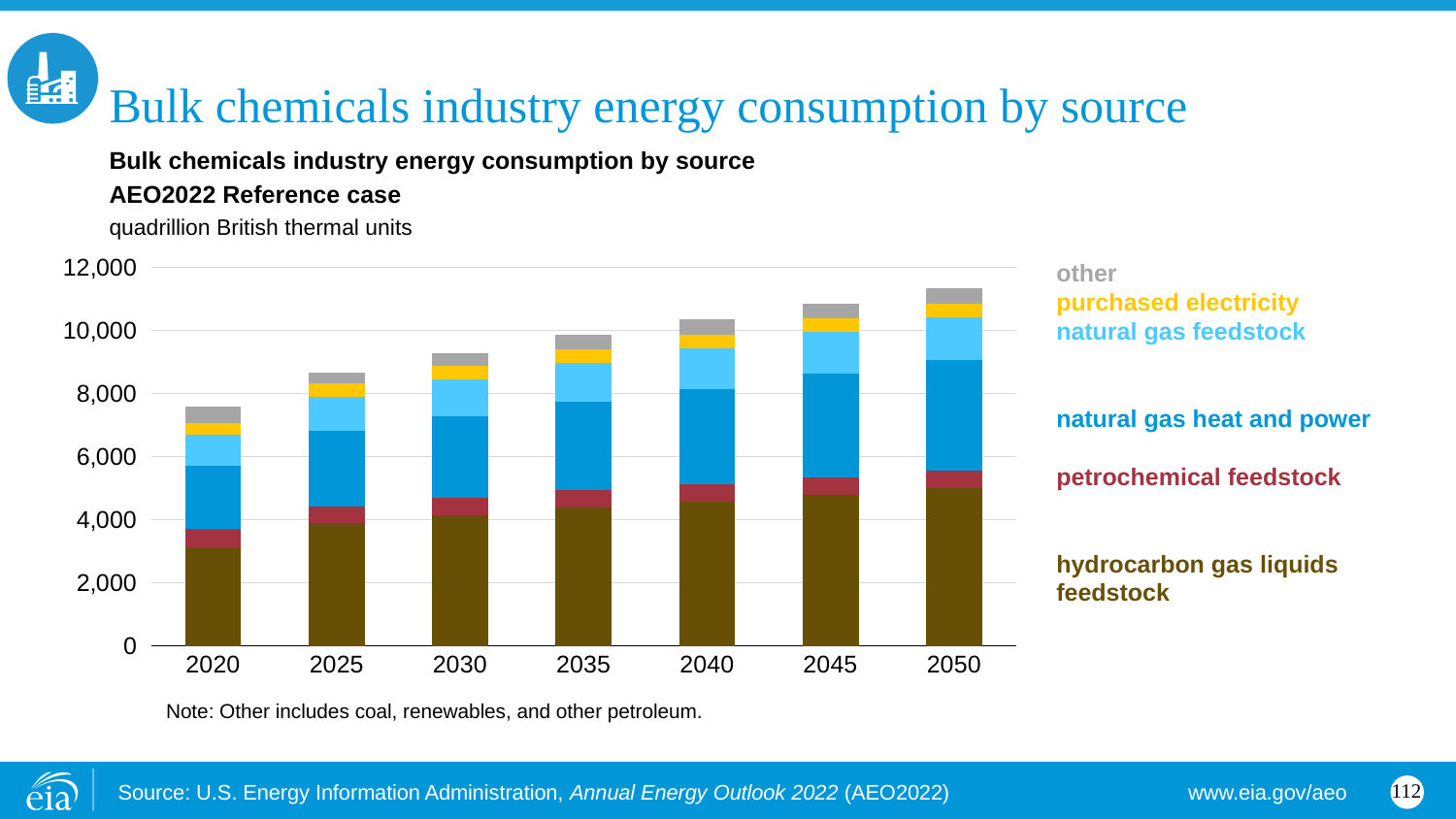
Is the hydrocarbon gas liquids feedstock segment for 2020 greater or less than 4,000? less Is the total stacked bar for 2030 greater or less than 10,000? less Which year has the tallest stacked bar? 2050 Which year has the shortest stacked bar? 2020 Do the total stacked bar heights rise or fall from 2020 to 2050? rise Is the total stacked bar for 2020 greater or less than 8,000? less Which is larger, the total stacked bar for 2025 or for 2045? 2045 What unit is the chart's y axis measured in? quadrillion British thermal units How many years are shown along the x axis of the chart? 7 How many series does the chart's legend list? 6 What kind of chart is shown on the slide? stacked bar chart